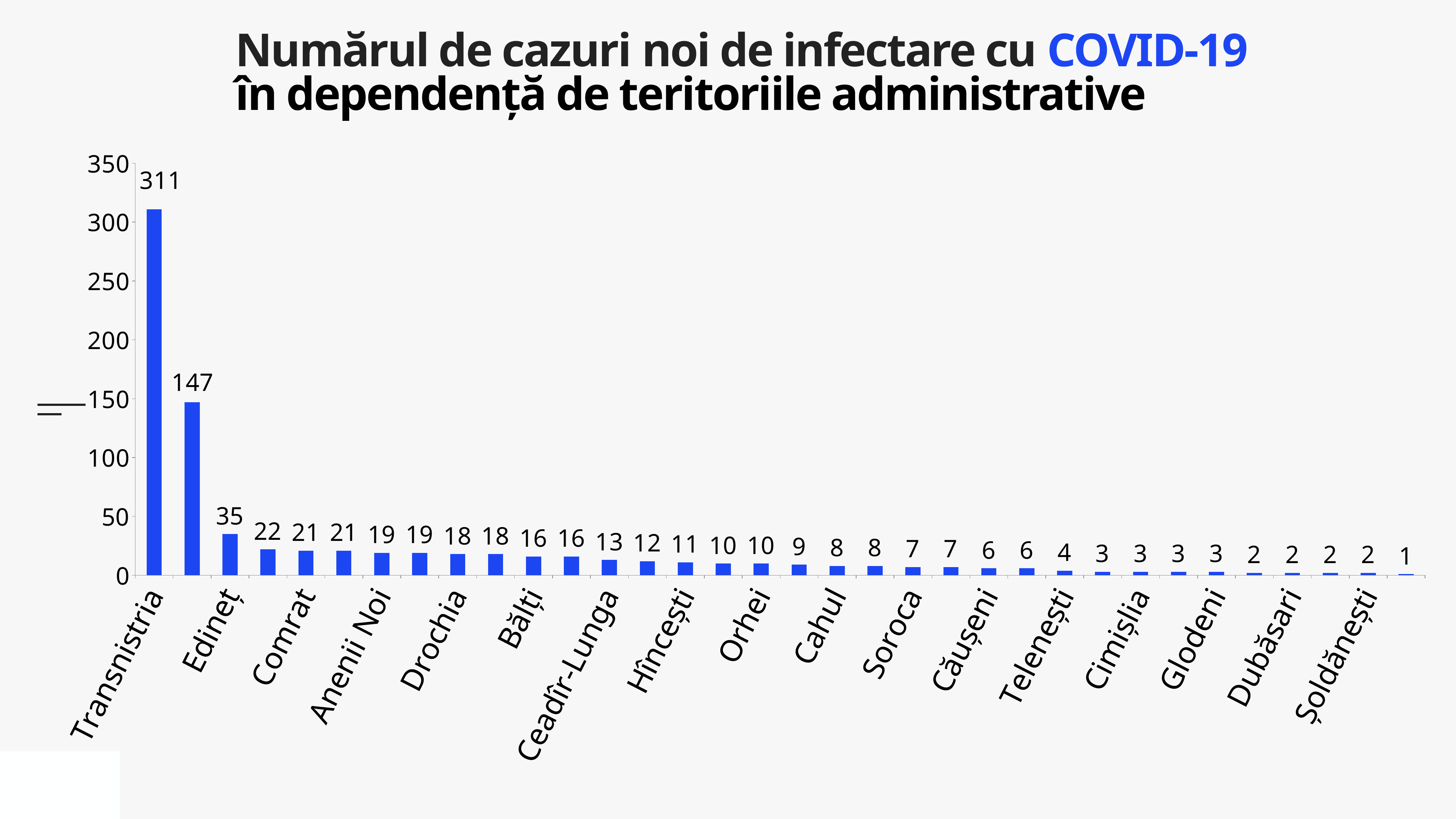
What kind of chart is shown on the slide? bar chart What is the value for Orhei? 10 What is the difference between the values for Transnistria and Edineț? 276 What is the value for Drochia? 18 What is the value for Transnistria? 311 Do the values rise or fall from left to right along the x axis? fall Which territory has the highest number of new cases? Transnistria What is the value for Edineț? 35 Which has a larger value, Bălți or Hîncești? Bălți What is the title of the chart? Numărul de cazuri noi de infectare cu COVID-19 în dependență de teritoriile administrative What is the value for Comrat? 21 Is the value for Transnistria greater or less than 300? greater